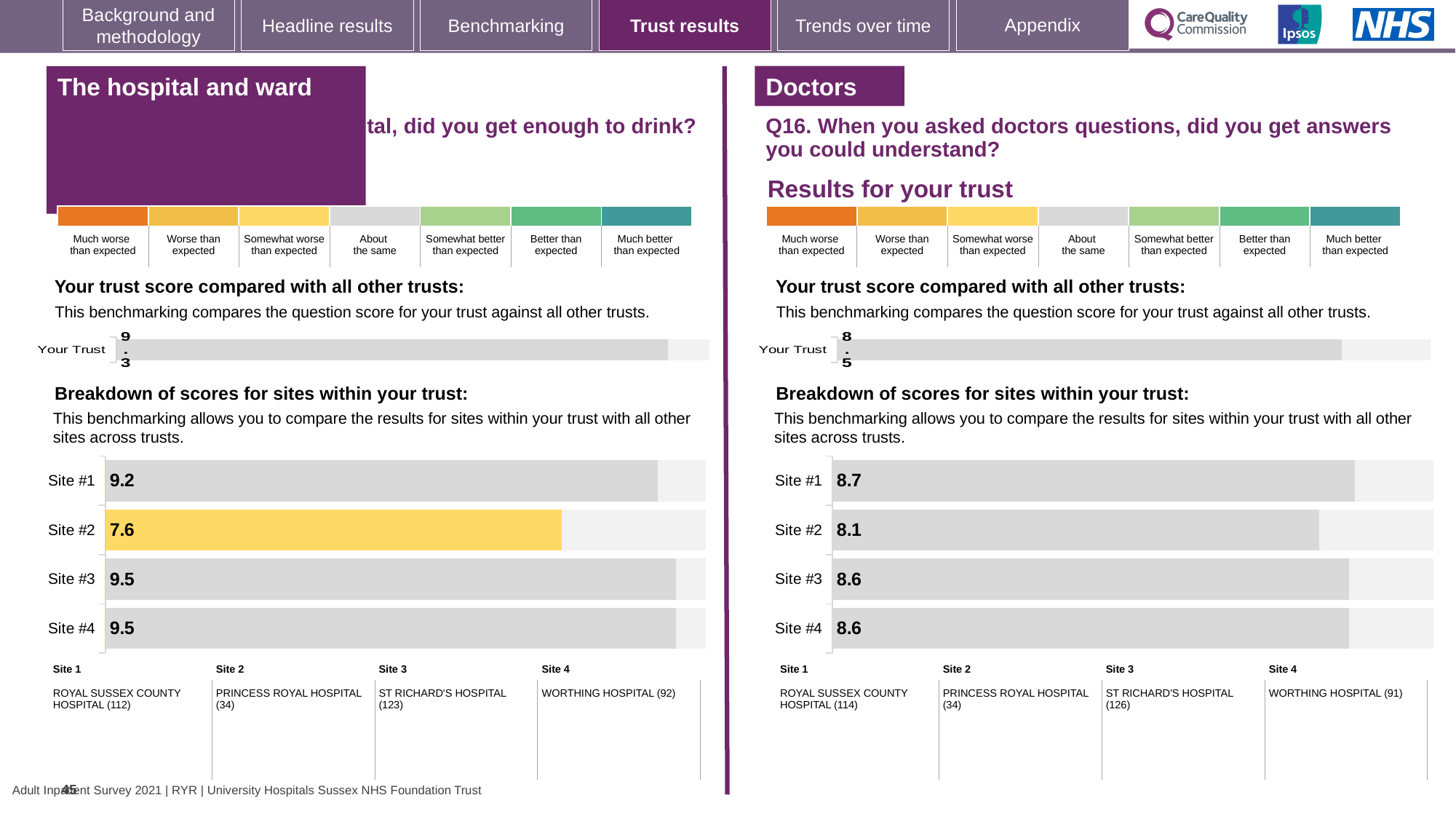
In the left-hand chart, what is the difference between the scores for Site #3 and Site #2? 1.9 In the right-hand chart (Q16), which site has the lowest score? Site #2 In the right-hand chart (Q16), which site has the highest score? Site #1 In the left-hand chart, what is the 'Your Trust' score? 9.3 In the right-hand chart (Q16), which has the higher score, Site #2 or Site #3? Site #3 How many sites are shown in the left-hand site breakdown chart? 4 In the right-hand chart (Q16), what is the difference between the scores for Site #1 and Site #2? 0.6 In the left-hand chart, which site has the lowest score? Site #2 In the left-hand chart (did you get enough to drink?), what is the score for Site #2? 7.6 In the right-hand chart (Q16, Doctors), what is the score for Site #1? 8.7 What type of chart is used for the site breakdown on the right-hand side? Bar chart In the right-hand chart (Q16), what is the 'Your Trust' score? 8.5